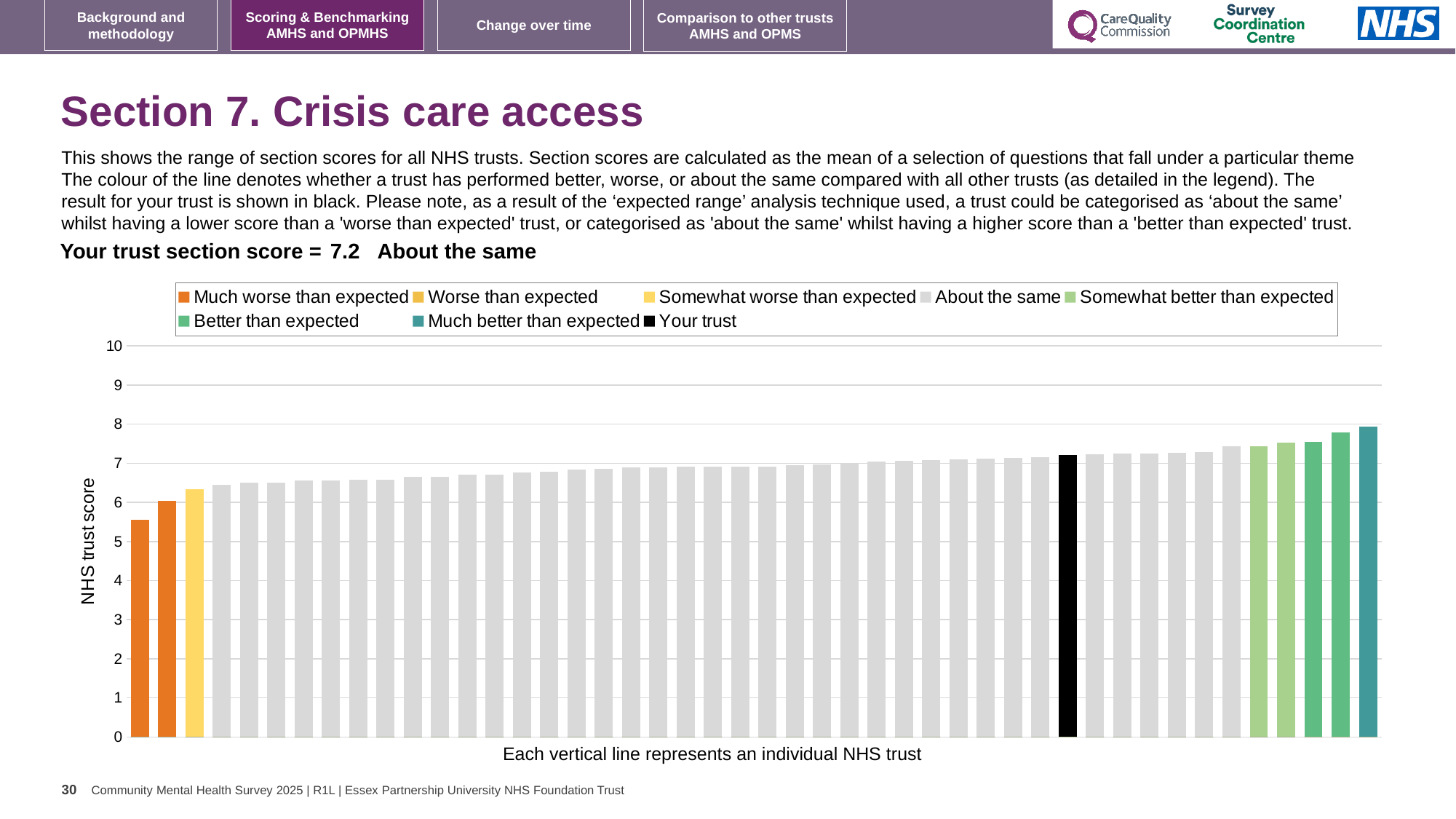
How many bars are coloured as 'Much better than expected'? 1 How many bars are coloured as 'Much worse than expected'? 2 Do the bar values rise or fall from left to right along the x axis? rise What kind of chart is shown on the slide? Bar chart How many entries does the chart legend list? 8 Is the value of the black 'Your trust' bar greater or less than 7? greater Is the value of the highest bar in the chart greater or less than 7? greater Is the value of the lowest bar in the chart greater or less than 6? less Which performance category is your trust placed in for crisis care access? About the same What is the label on the vertical axis of the chart? NHS trust score What is the section score for your trust shown on the slide? 7.2 Which legend category does the highest bar in the chart belong to? Much better than expected